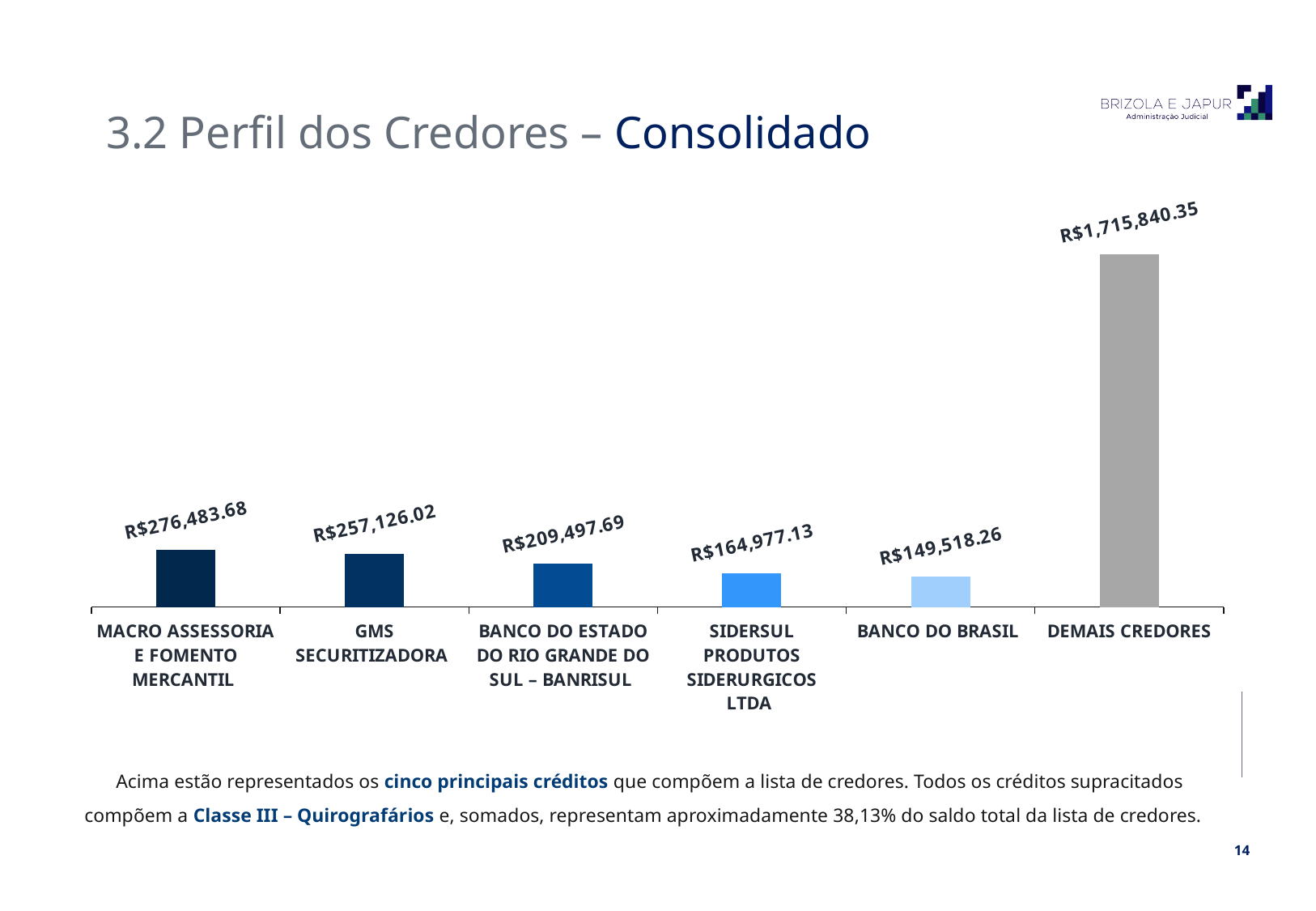
What is the value shown for DEMAIS CREDORES? R$1,715,840.35 What is the value shown for BANCO DO BRASIL? R$149,518.26 What is the difference between the values for SIDERSUL PRODUTOS SIDERURGICOS LTDA and BANCO DO BRASIL? R$15,458.87 How many categories are shown in the chart? 6 What is the value shown for SIDERSUL PRODUTOS SIDERURGICOS LTDA? R$164,977.13 Which category has the lowest value? BANCO DO BRASIL What is the value shown for GMS SECURITIZADORA? R$257,126.02 What kind of chart is shown on the slide? Bar chart Do the values rise or fall from MACRO ASSESSORIA E FOMENTO MERCANTIL to BANCO DO BRASIL? Fall Which category has the highest value? DEMAIS CREDORES Which is larger, the value for BANCO DO ESTADO DO RIO GRANDE DO SUL – BANRISUL or the value for SIDERSUL PRODUTOS SIDERURGICOS LTDA? BANCO DO ESTADO DO RIO GRANDE DO SUL – BANRISUL What is the difference between the values for MACRO ASSESSORIA E FOMENTO MERCANTIL and GMS SECURITIZADORA? R$19,357.66